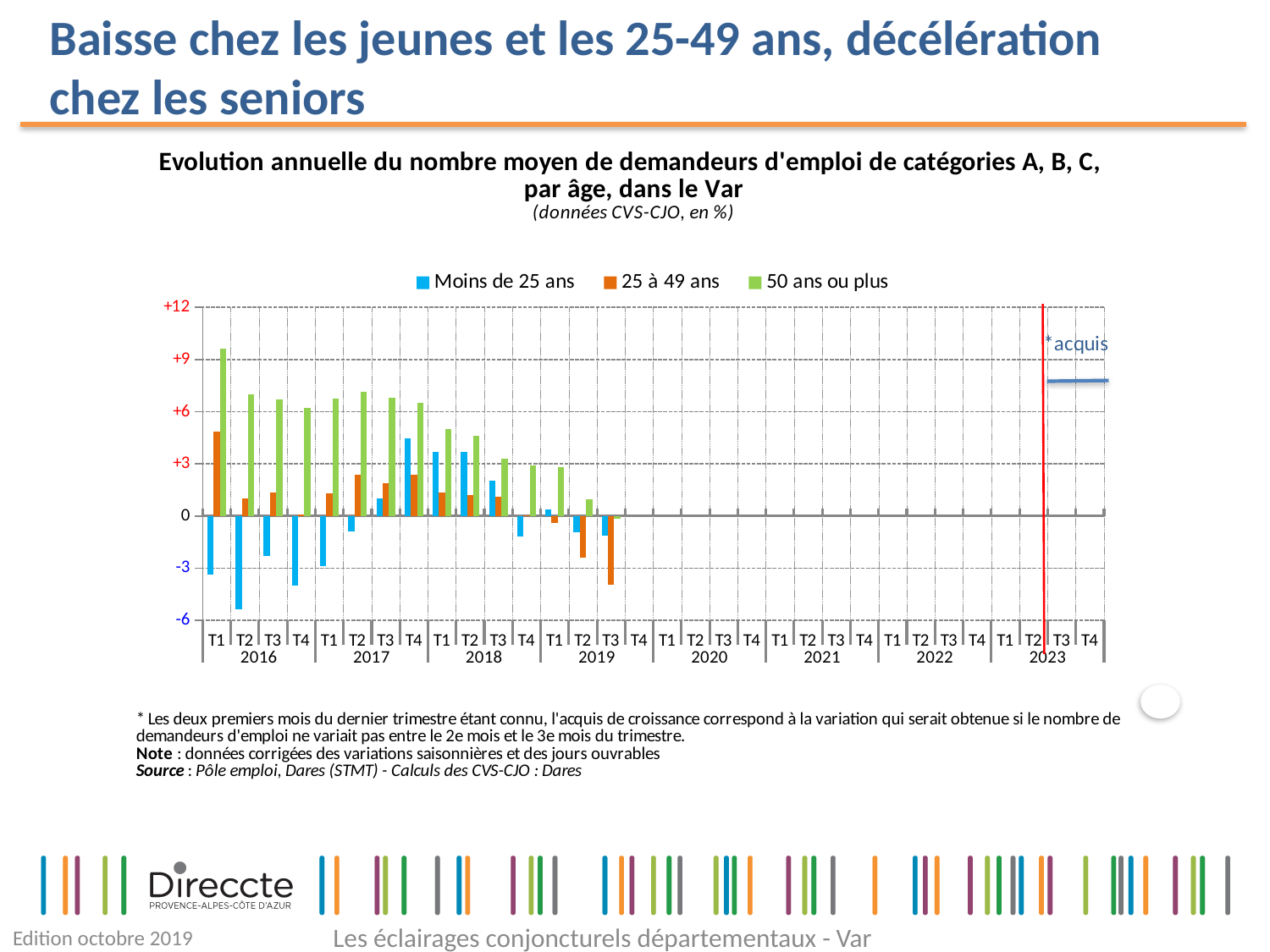
What kind of chart is shown on the slide? bar chart Which series does the green colour represent in the legend? 50 ans ou plus Is the value for Moins de 25 ans in T2 2016 greater or less than -3? less Is the value for 50 ans ou plus in T1 2016 greater or less than +9? greater Is the value for 25 à 49 ans in T3 2019 greater or less than -3? less How many series does the legend list? 3 Which age group has the highest value in T1 2016? 50 ans ou plus Which is larger in T1 2016: the value for 50 ans ou plus or the value for 25 à 49 ans? 50 ans ou plus Do the values for 50 ans ou plus generally rise or fall from 2016 to 2019? fall How many years are labelled along the x axis? 8